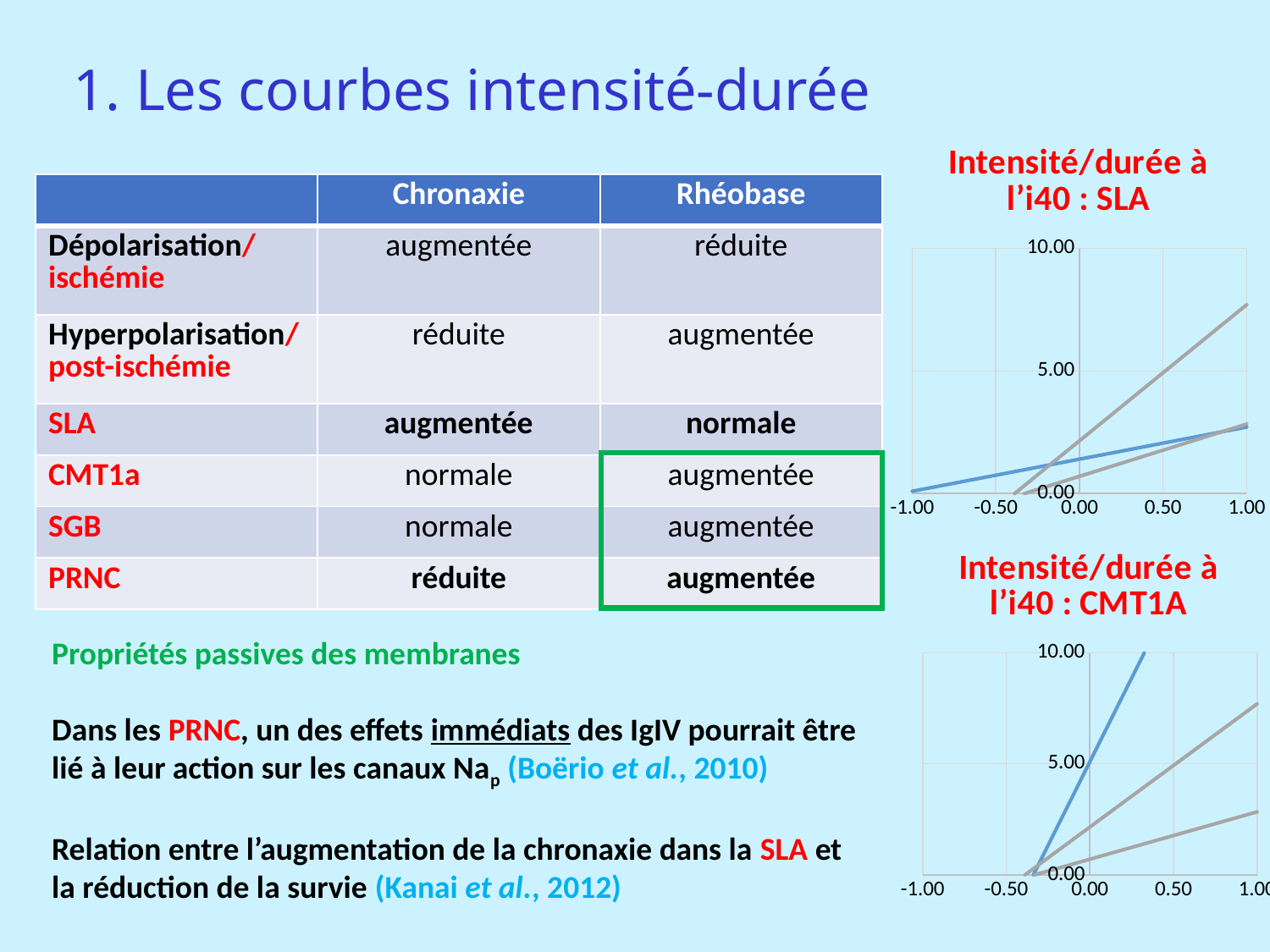
On the chart titled "Intensité/durée à l'i40 : SLA", is the value of the steeper grey line at x = 1.00 greater or less than 5.00? greater On the chart titled "Intensité/durée à l'i40 : SLA", do the plotted lines rise or fall as x increases? rise What is the title of the lower chart on the right side of the slide? Intensité/durée à l'i40 : CMT1A How many lines are plotted on the chart titled "Intensité/durée à l'i40 : CMT1A"? 3 On the chart titled "Intensité/durée à l'i40 : CMT1A", is the value of the lower grey line at x = 1.00 greater or less than 5.00? less On the chart titled "Intensité/durée à l'i40 : SLA", is the value of the blue line at x = 1.00 greater or less than 5.00? less What kind of chart is the chart titled "Intensité/durée à l'i40 : CMT1A"? line chart How many lines are plotted on the chart titled "Intensité/durée à l'i40 : SLA"? 3 What kind of chart is the chart titled "Intensité/durée à l'i40 : SLA"? line chart What is the maximum value shown on the y axis of the chart titled "Intensité/durée à l'i40 : SLA"? 10.00 On the chart titled "Intensité/durée à l'i40 : CMT1A", do the plotted lines rise or fall as x increases? rise